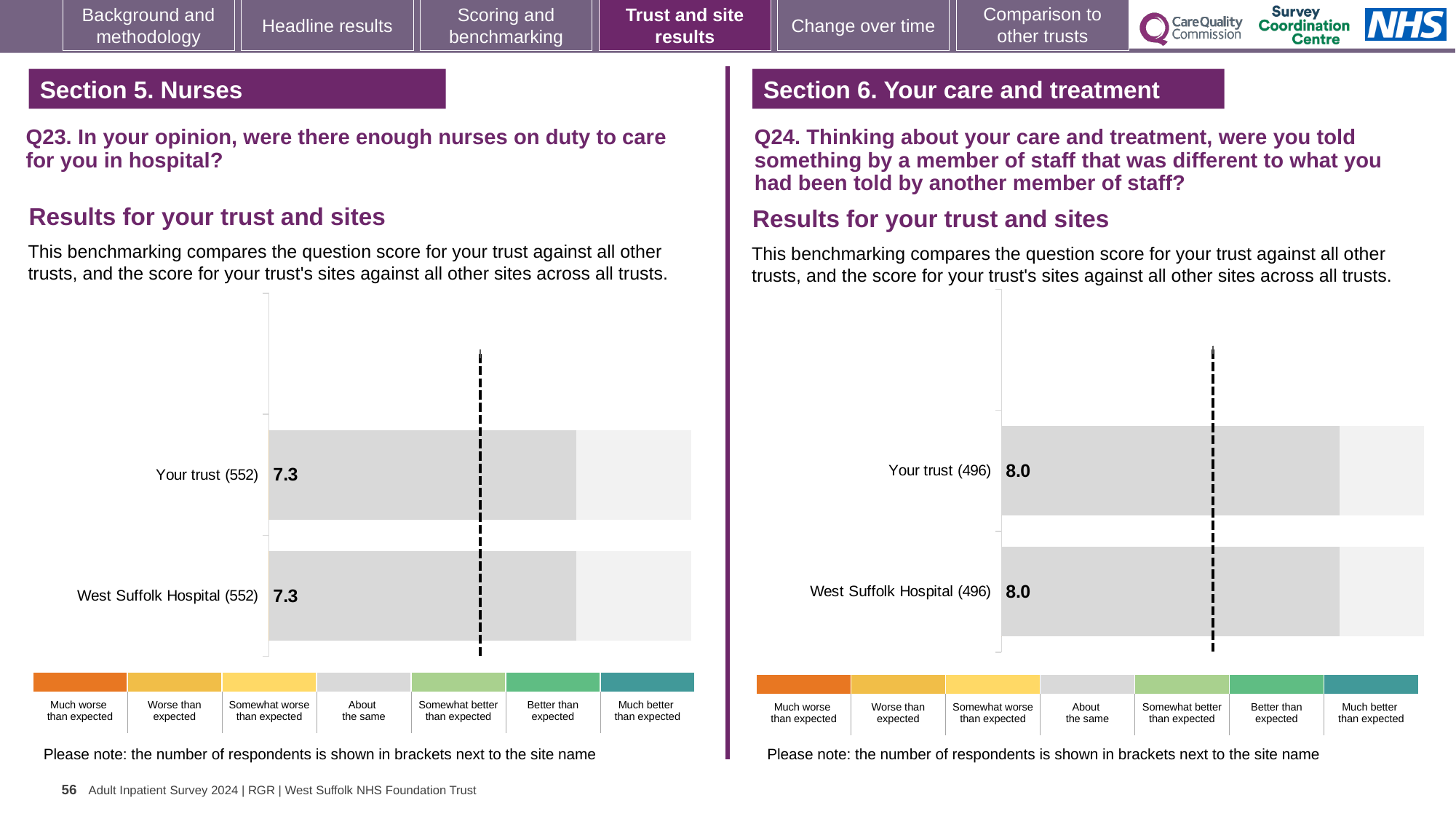
Is the Your trust score on the Q24 chart (right) larger or smaller than the Your trust score on the Q23 chart (left)? Larger On the Q23 chart (left), how many respondents are shown in brackets for Your trust? 552 On the Q24 chart (right), what is the score for Your trust? 8.0 On the Q23 chart (left), what is the score for Your trust? 7.3 On the Q24 chart (right), how many respondents are shown in brackets for West Suffolk Hospital? 496 On the Q24 chart (right), what is the score for West Suffolk Hospital? 8.0 What kind of chart is used on the Q23 chart (left)? Bar chart How many bars are plotted on the Q23 chart (left)? 2 On the Q24 chart (right), what is the difference between the Your trust score and the West Suffolk Hospital score? 0.0 How many bars are plotted on the Q24 chart (right)? 2 On the Q23 chart (left), what is the score for West Suffolk Hospital? 7.3 On the Q23 chart (left), what is the difference between the Your trust score and the West Suffolk Hospital score? 0.0